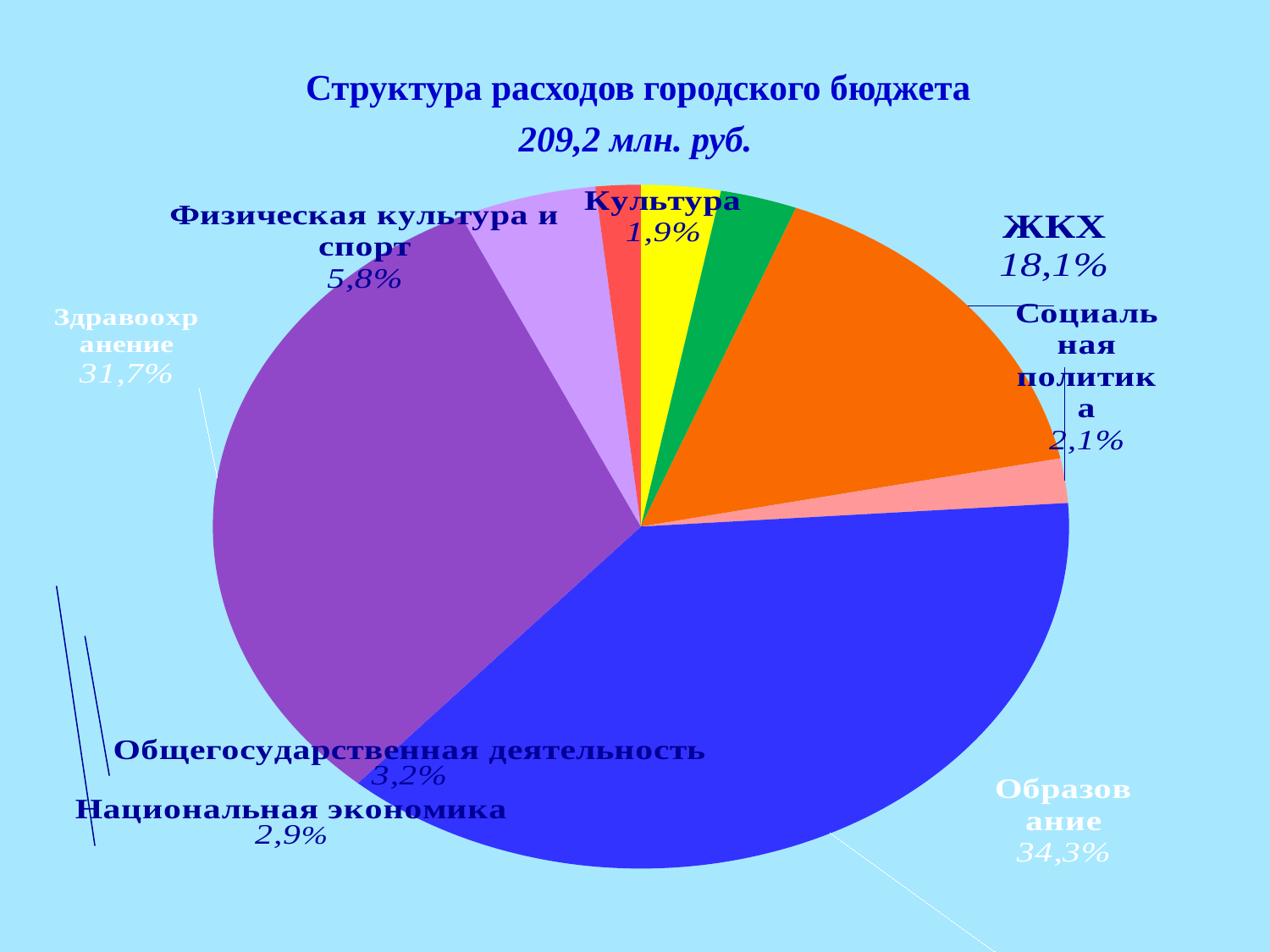
What kind of chart is shown on the slide? pie chart What is the difference in percentage points between Образование and Здравоохранение? 2,6 What is the value shown for ЖКХ? 18,1% What share of the budget expenditure goes to Образование? 34,3% How many categories are shown in the pie chart? 8 What is the value shown for Национальная экономика? 2,9% What is the title of the chart? Структура расходов городского бюджета 209,2 млн. руб. Which category has the smallest share of expenditure? Культура Which is larger, the share for Общегосударственная деятельность or for Социальная политика? Общегосударственная деятельность What is the value shown for Физическая культура и спорт? 5,8% What share of the budget expenditure goes to Здравоохранение? 31,7% Which category has the largest share of expenditure? Образование